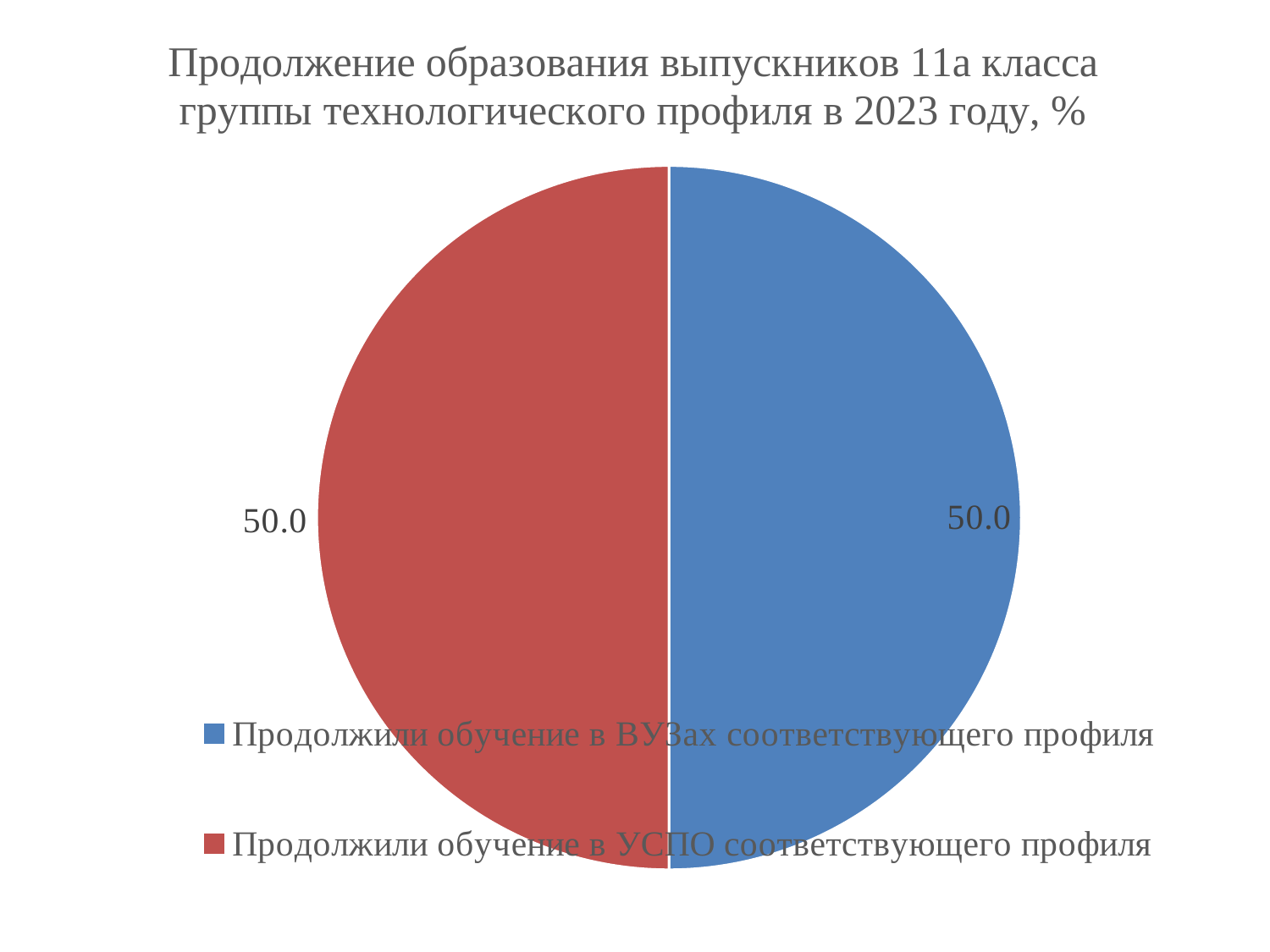
What is the title of the chart? Продолжение образования выпускников 11а класса группы технологического профиля в 2023 году, % How many slices does the pie chart have? 2 What share of the pie does the "Продолжили обучение в УСПО соответствующего профиля" slice represent? 50.0 What is the value for "Продолжили обучение в ВУЗах соответствующего профиля"? 50.0 How many entries does the legend list? 2 What colour is the slice for "Продолжили обучение в ВУЗах соответствующего профиля"? blue What is the value for "Продолжили обучение в УСПО соответствующего профиля"? 50.0 What kind of chart is shown on the slide? pie chart What is the total of the two slice values shown on the chart? 100.0 What is the difference between the values for "Продолжили обучение в ВУЗах соответствующего профиля" and "Продолжили обучение в УСПО соответствующего профиля"? 0.0